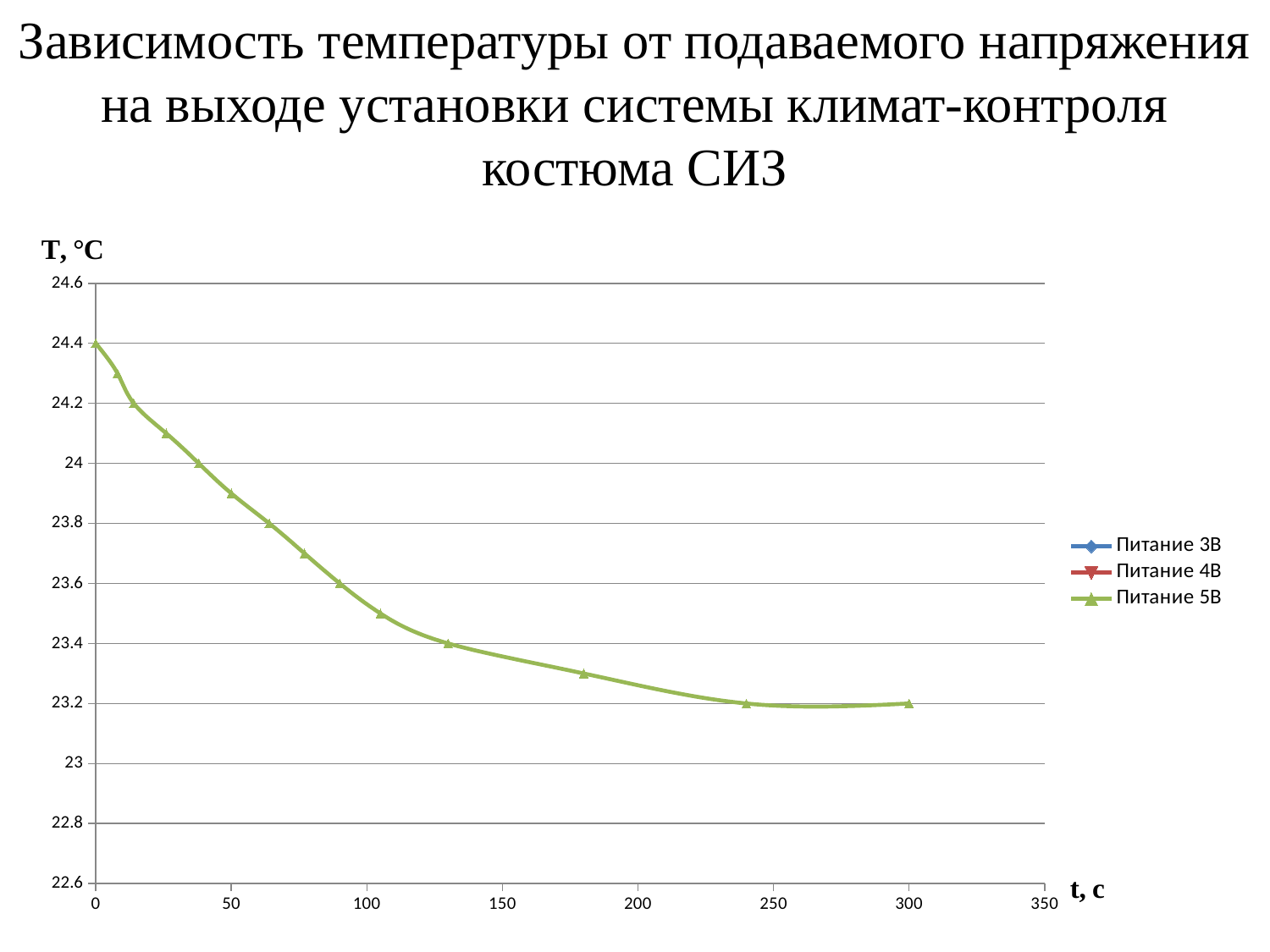
What is the label of the y axis? T, °C What type of chart is shown on the slide? line chart How many series does the legend list? 3 Is the temperature at t = 150 s greater or less than 23.6? less How many data points are plotted on the visible line? 14 Which is larger: the temperature at t = 0 s or at t = 300 s? t = 0 s What is the temperature value at t = 300 s? 23.2 What is the difference between the temperature at t = 0 s and at t = 300 s? 1.2 Is the temperature at t = 200 s greater or less than 23.4? less What is the temperature value at t = 0 s? 24.4 Does the temperature rise or fall as time increases along the x axis? fall At which time is the temperature highest? 0